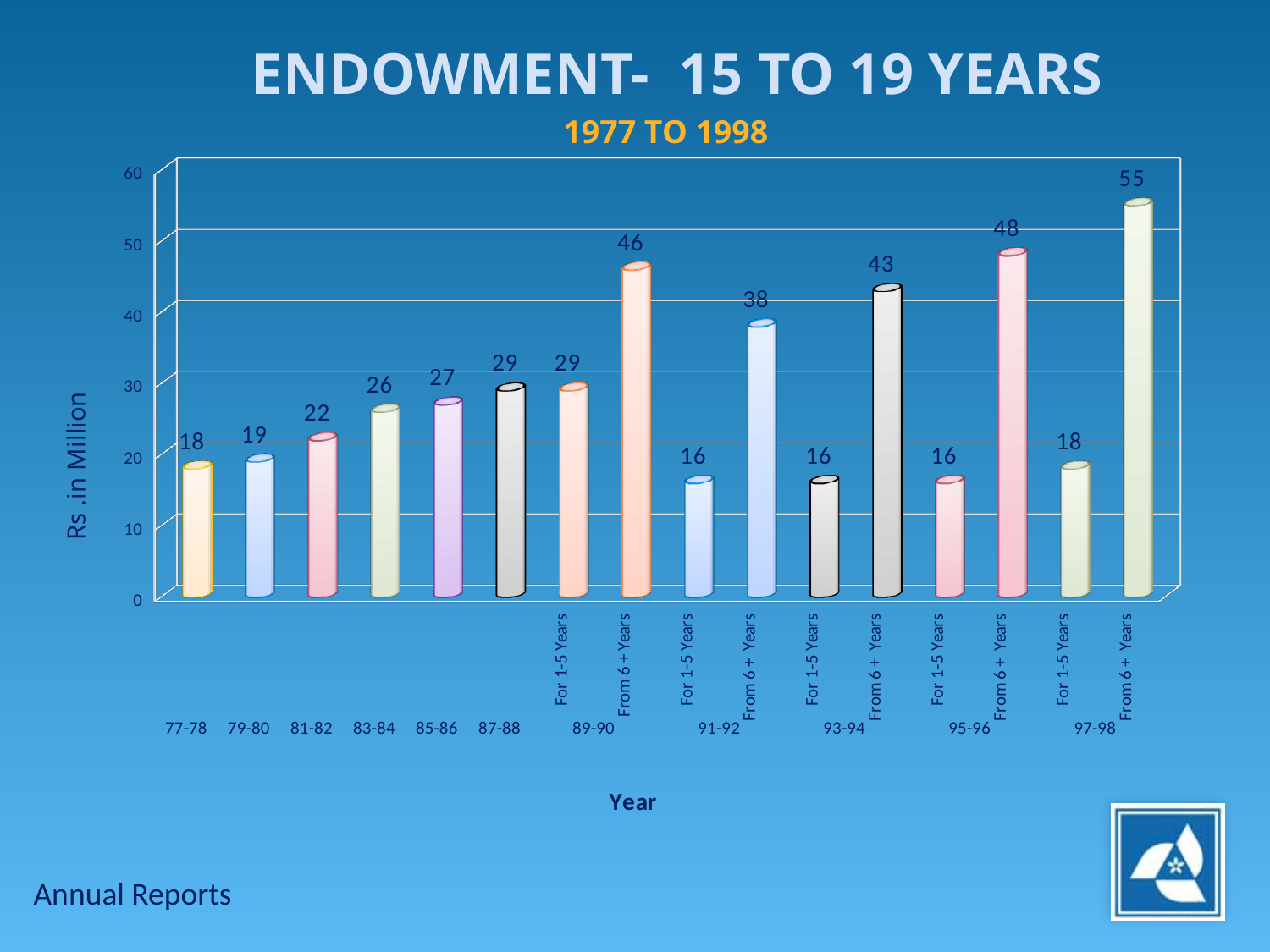
What is the lowest value shown on the chart? 16 Which is larger: the 'From 6 + Years' value for 91-92 or the 'From 6 + Years' value for 93-94? 93-94 From 6 + Years What is the value for 'For 1-5 Years' in 93-94? 16 What is the difference between the 'From 6 + Years' value for 97-98 and the 'For 1-5 Years' value for 97-98? 37 What is the value for 83-84? 26 What kind of chart is shown on the slide? Bar chart What is the value for 'From 6 + Years' in 89-90? 46 What is the value for 77-78? 18 Which bar has the highest value? 97-98 From 6 + Years What is the title of the chart? ENDOWMENT- 15 TO 19 YEARS What is the label of the vertical axis? Rs .in Million How many bars are plotted on the chart? 16